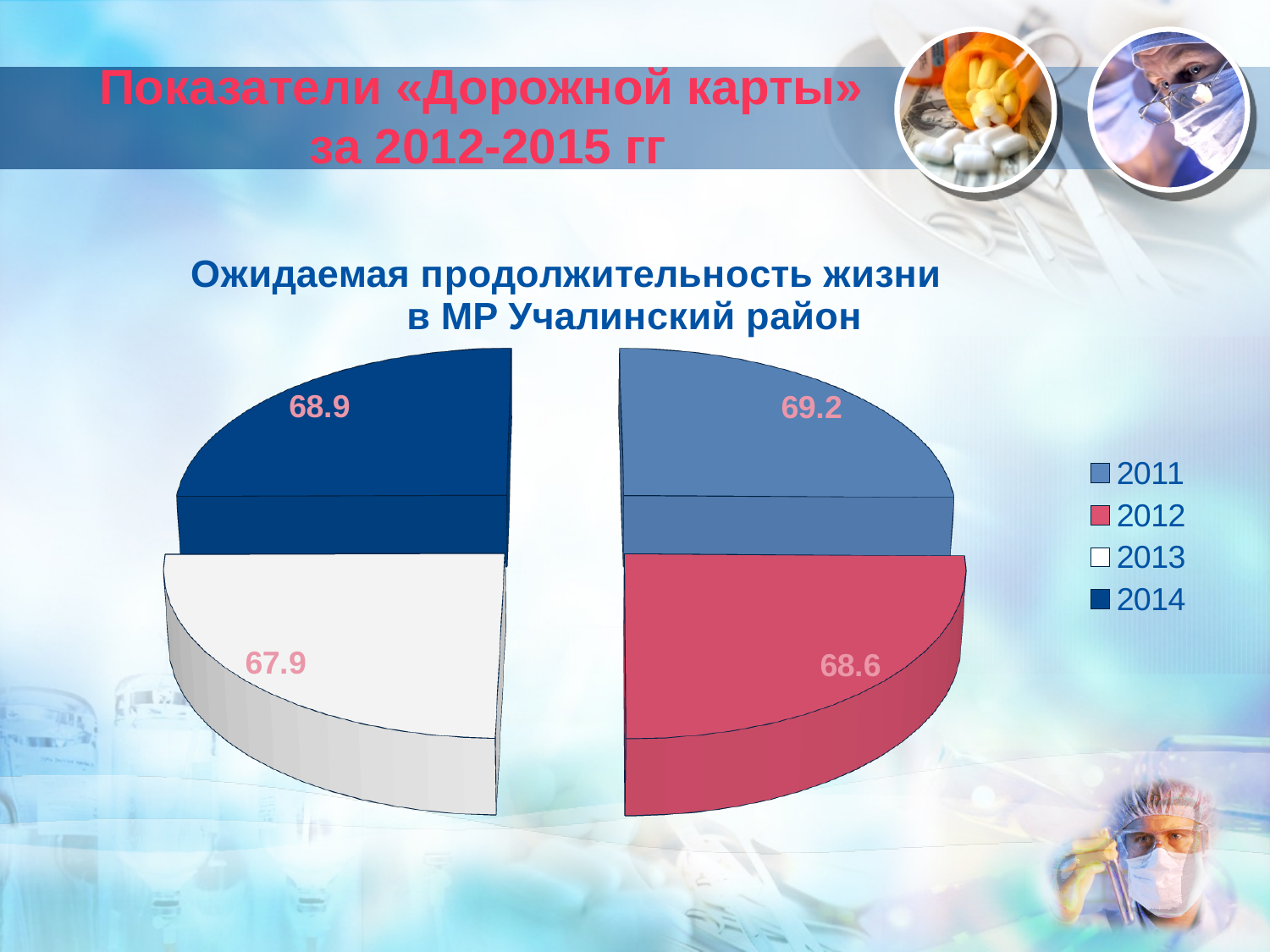
Which year has the highest value on the pie chart? 2011 What is the title of the chart? Ожидаемая продолжительность жизни в МР Учалинский район What is the difference between the values for 2011 and 2013? 1.3 How many entries does the legend list? 4 Which is larger, the value for 2014 or the value for 2012? 2014 What is the value shown for 2012 on the pie chart? 68.6 Which year has the lowest value on the pie chart? 2013 What is the value shown for 2013 on the pie chart? 67.9 What is the value shown for 2014 on the pie chart? 68.9 How many slices does the pie chart have? 4 What is the value shown for 2011 on the pie chart? 69.2 What kind of chart is shown on the slide? Pie chart